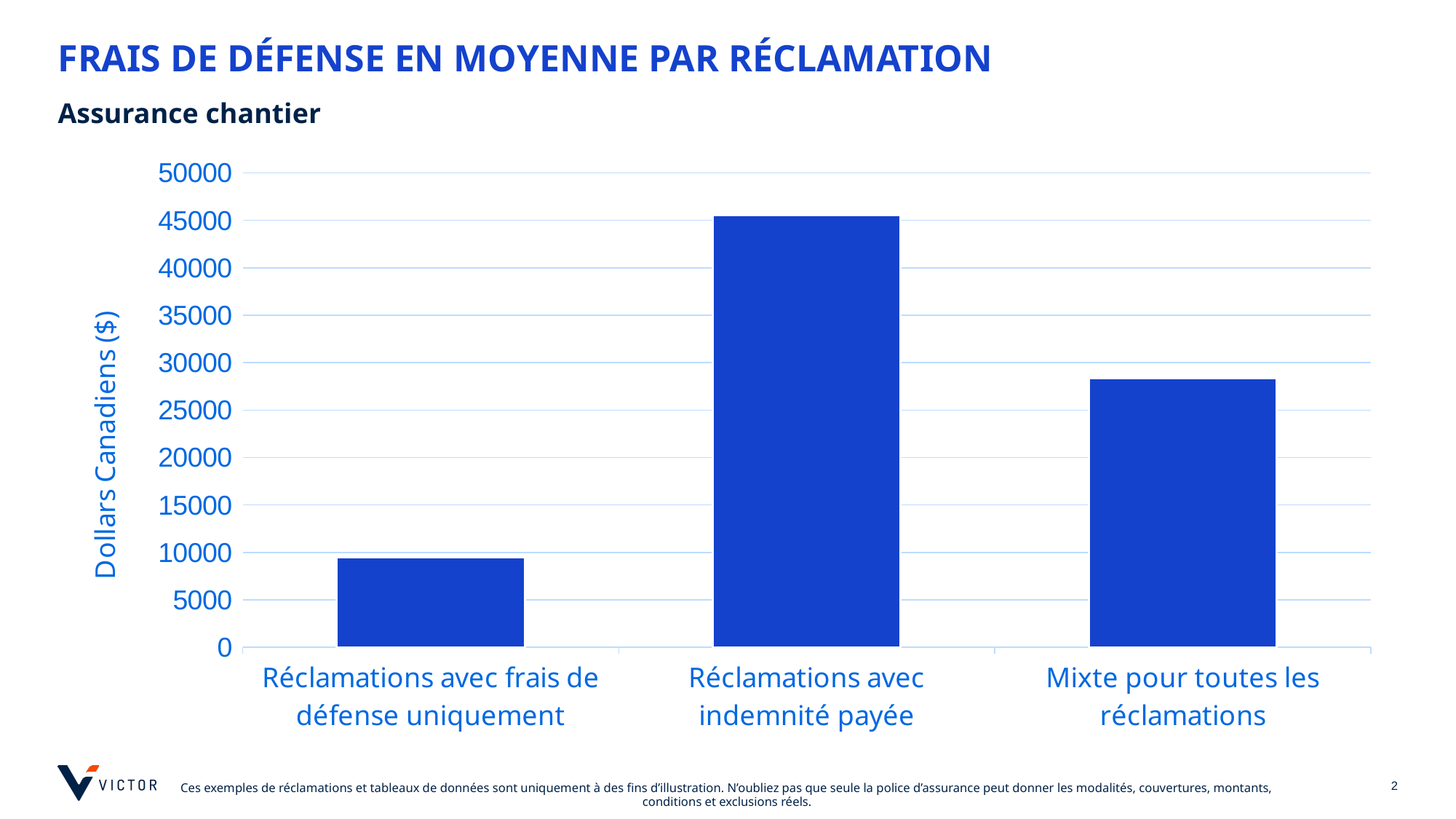
What is the title of the slide containing the chart? FRAIS DE DÉFENSE EN MOYENNE PAR RÉCLAMATION Is the value for 'Réclamations avec frais de défense uniquement' greater or less than 10000? less What kind of chart is shown on the slide? bar chart Which category has the highest average defence cost? Réclamations avec indemnité payée Is the value for 'Mixte pour toutes les réclamations' greater or less than 25000? greater Which is larger: the value for 'Réclamations avec indemnité payée' or the value for 'Mixte pour toutes les réclamations'? Réclamations avec indemnité payée Which is larger: the value for 'Mixte pour toutes les réclamations' or the value for 'Réclamations avec frais de défense uniquement'? Mixte pour toutes les réclamations What is the label of the vertical axis? Dollars Canadiens ($) Which category has the lowest average defence cost? Réclamations avec frais de défense uniquement Is the value for 'Réclamations avec indemnité payée' greater or less than 40000? greater How many categories are plotted on the chart? 3